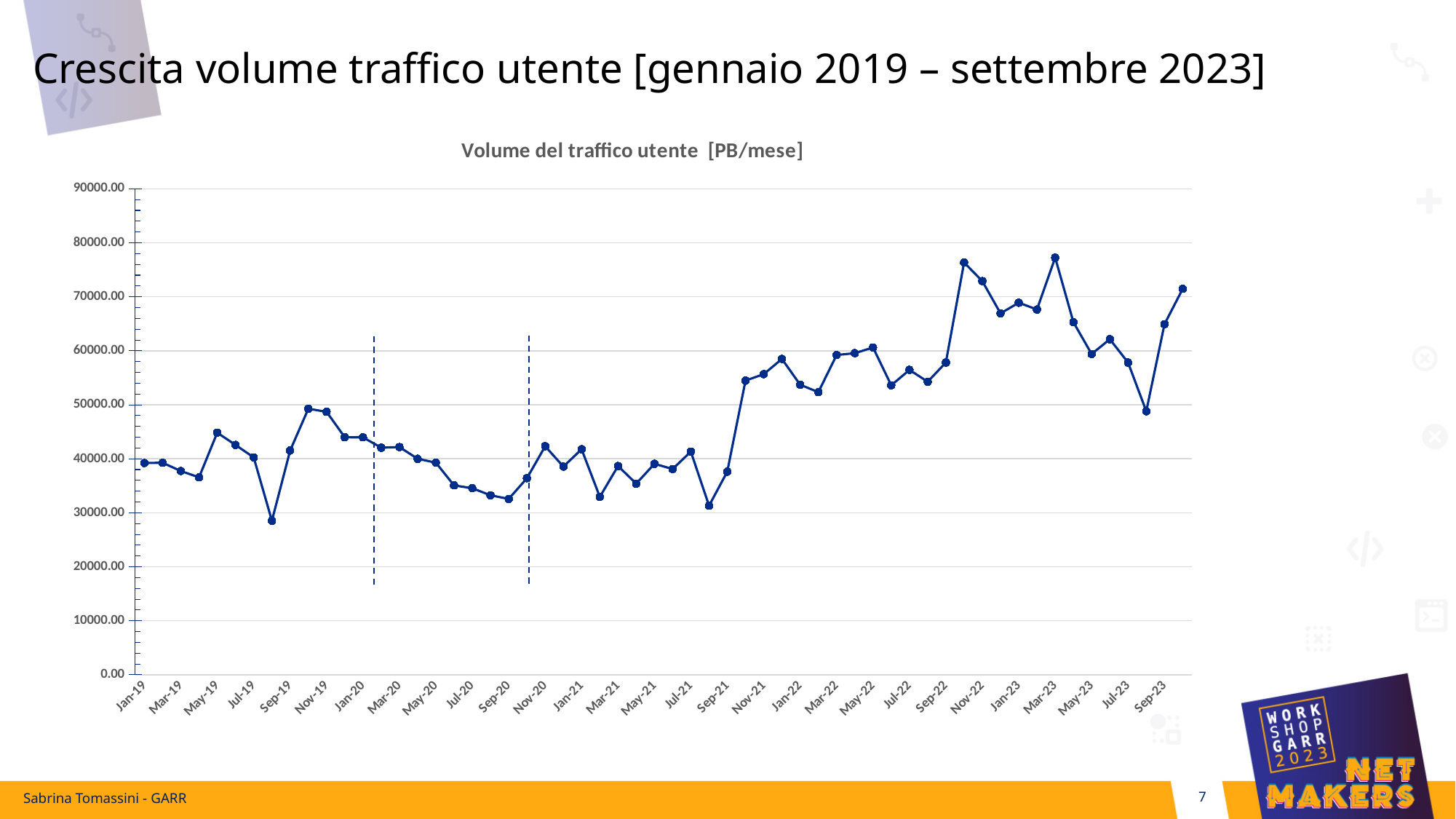
Which is larger, the value for Oct-19 or the value for Aug-19? Oct-19 What kind of chart is shown on the slide? line chart What is the highest value shown on the vertical axis? 90000.00 Is the value for Aug-19 greater or less than 30000? less Is the value for Sep-21 greater or less than 40000? less Is the value for Nov-21 greater or less than 50000? greater What is the title of the chart? Volume del traffico utente [PB/mese] Which is larger, the value for Sep-23 or the value for Jan-19? Sep-23 Which month has the lowest traffic volume in the chart? Aug-19 Overall, do the values rise or fall from Jan-19 to Sep-23? rise